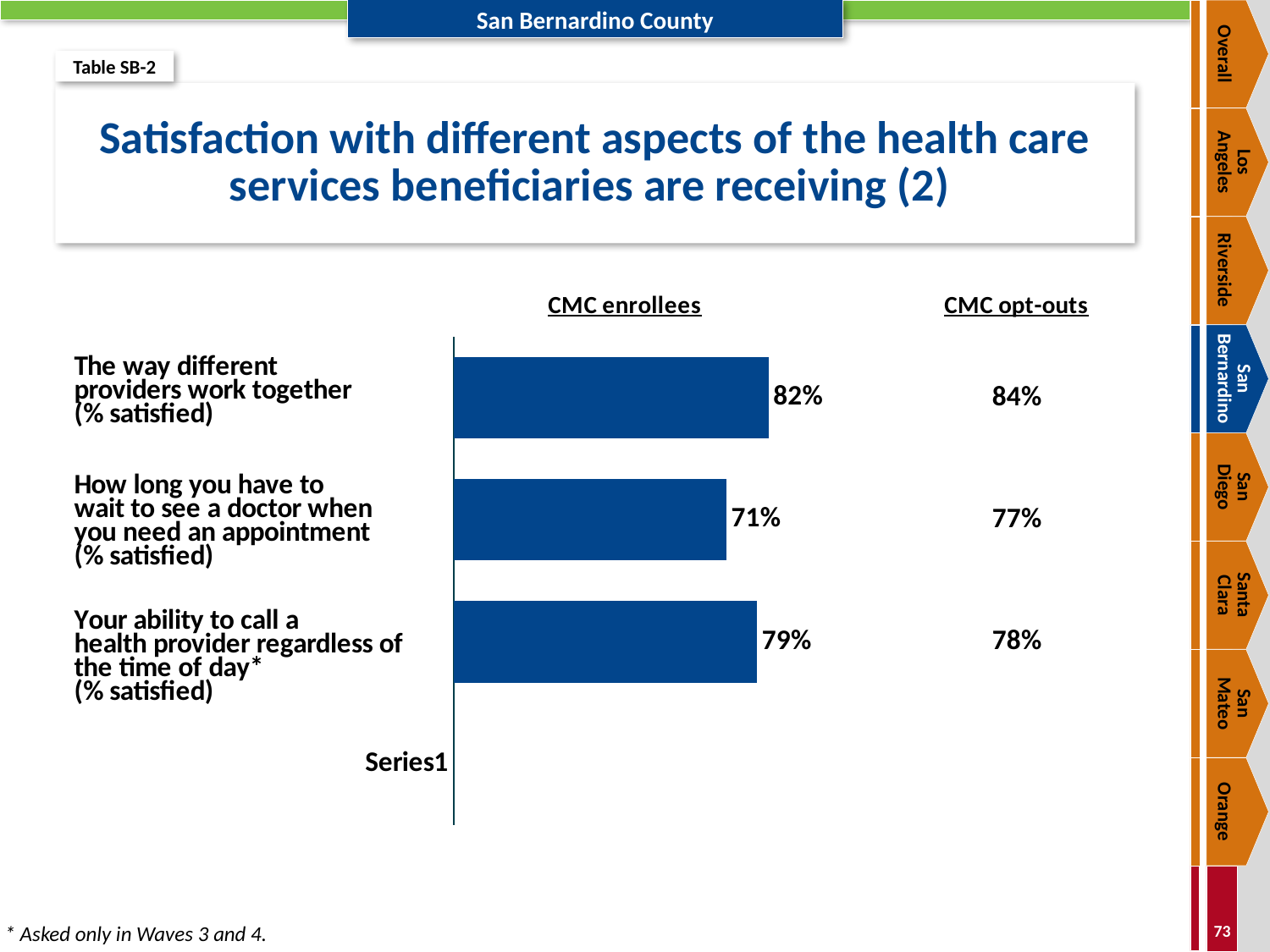
What is the CMC opt-outs value for 'The way different providers work together (% satisfied)'? 84% How many aspects of health care services are plotted as bars in the chart? 3 Which aspect has the lowest CMC enrollees satisfaction bar? How long you have to wait to see a doctor when you need an appointment What is the CMC enrollees value for 'The way different providers work together (% satisfied)'? 82% Which aspect has the highest CMC enrollees satisfaction bar? The way different providers work together What is the CMC enrollees value for 'How long you have to wait to see a doctor when you need an appointment (% satisfied)'? 71% What kind of chart is shown on the slide? Bar chart For 'Your ability to call a health provider regardless of the time of day', which is larger: the CMC enrollees value or the CMC opt-outs value? CMC enrollees What is the CMC enrollees value for 'Your ability to call a health provider regardless of the time of day (% satisfied)'? 79% What is the difference between the CMC enrollees values for 'The way different providers work together' and 'How long you have to wait to see a doctor when you need an appointment'? 11% What is the title of the chart on the slide? Satisfaction with different aspects of the health care services beneficiaries are receiving (2) What is the CMC opt-outs value for 'How long you have to wait to see a doctor when you need an appointment (% satisfied)'? 77%